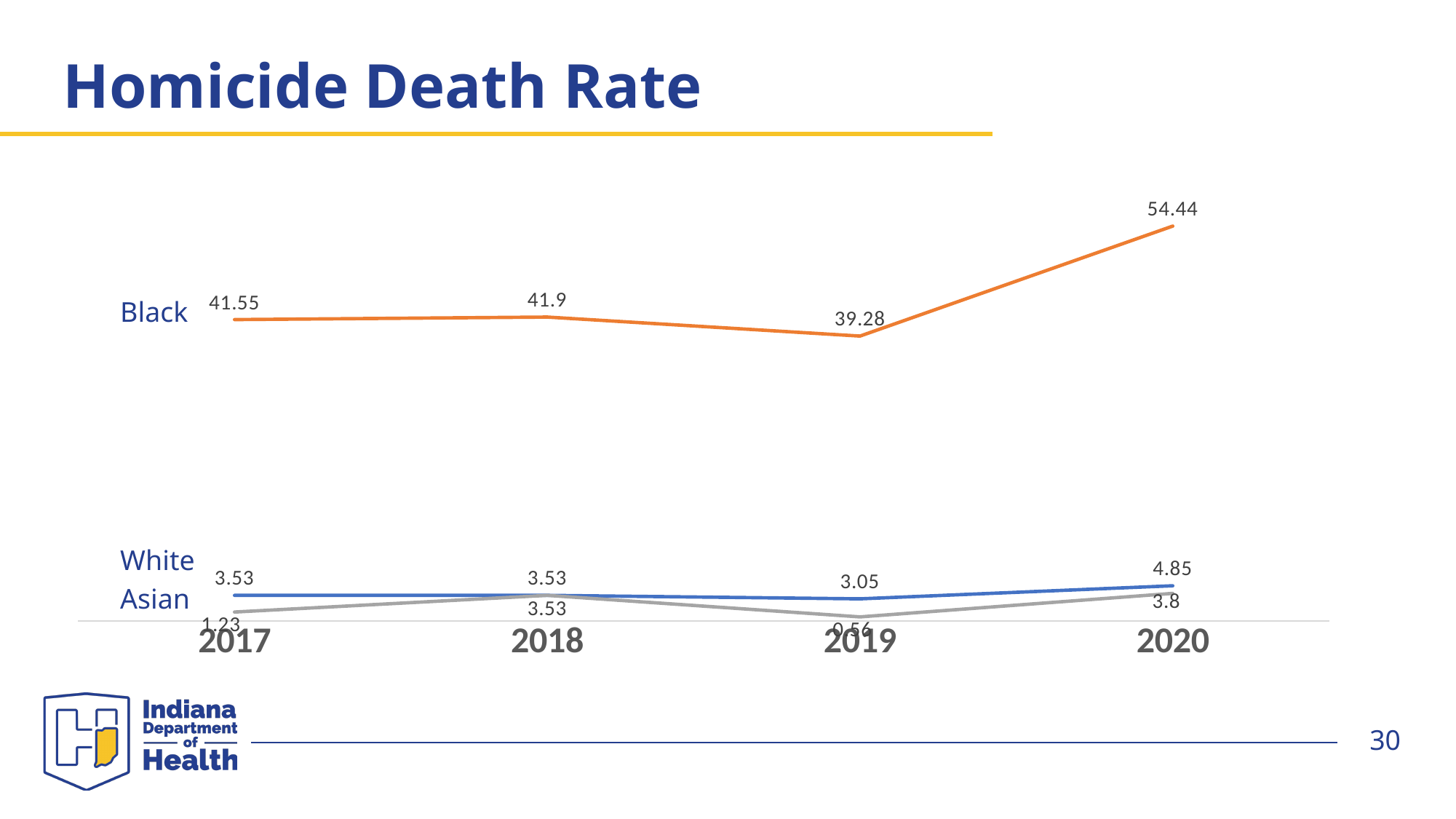
In 2020, which group has the higher homicide death rate, White or Asian? White What is the homicide death rate for Asian in 2020? 3.8 In which year is the Black homicide death rate lowest? 2019 In which year is the Black homicide death rate highest? 2020 How many years are shown on the x axis? 4 What is the homicide death rate for Black in 2020? 54.44 By how much did the Black homicide death rate increase from 2019 to 2020? 15.16 What is the homicide death rate for Black in 2019? 39.28 What kind of chart is shown on the slide? line chart How many series (groups) are plotted on the chart? 3 Does the Black homicide death rate rise or fall from 2019 to 2020? rise What is the homicide death rate for White in 2020? 4.85